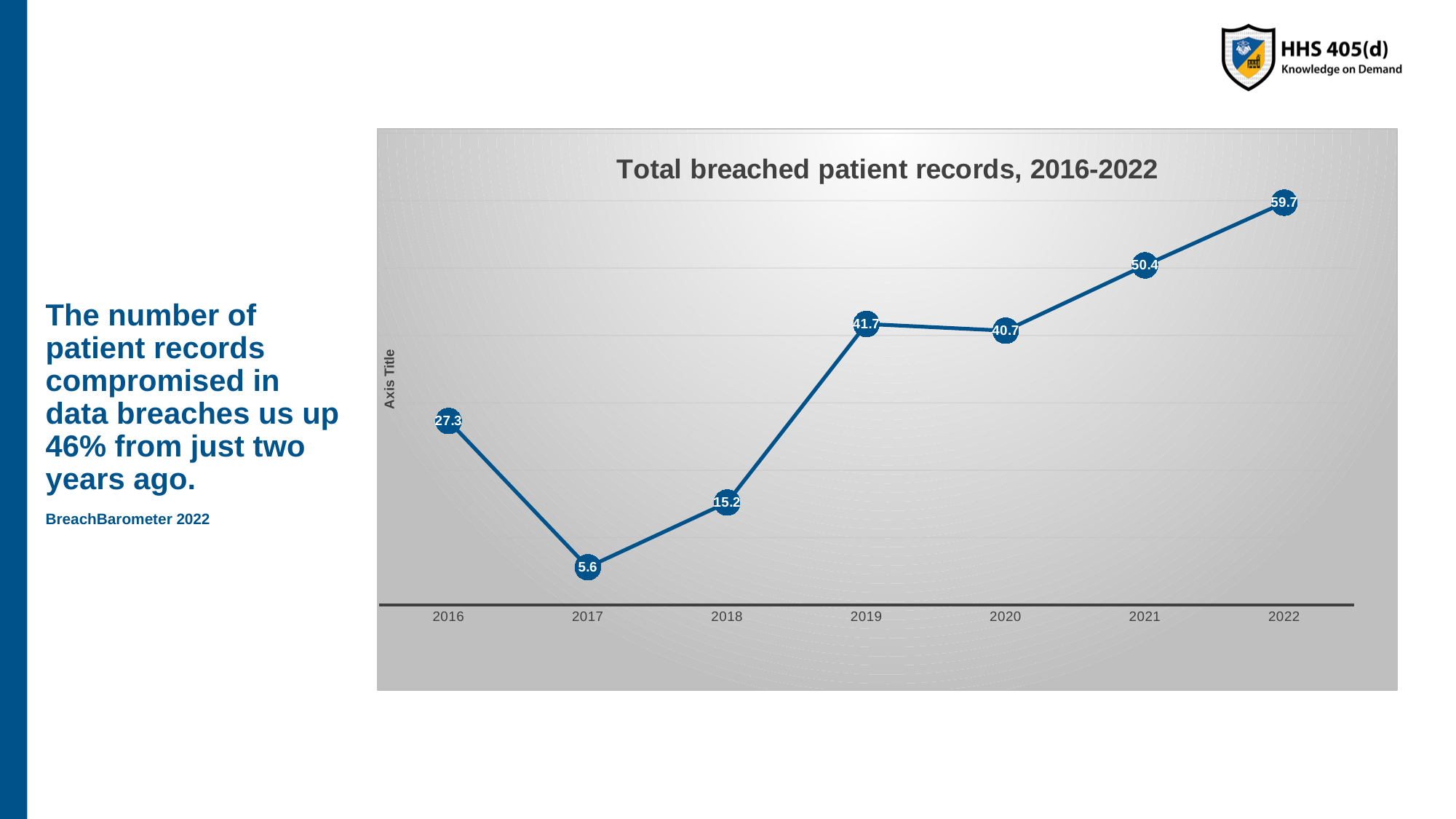
What is the title of the chart? Total breached patient records, 2016-2022 What is the value for 2022? 59.7 Which year has the lowest value? 2017 What is the difference between the values for 2022 and 2020? 19 What is the value for 2017? 5.6 Which is larger, the value for 2019 or the value for 2020? 2019 What kind of chart is shown on the slide? line chart Do the values rise or fall from 2017 to 2019? rise How many years are plotted on the chart? 7 Which year has the highest value? 2022 What is the value for 2016? 27.3 What is the value for 2020? 40.7